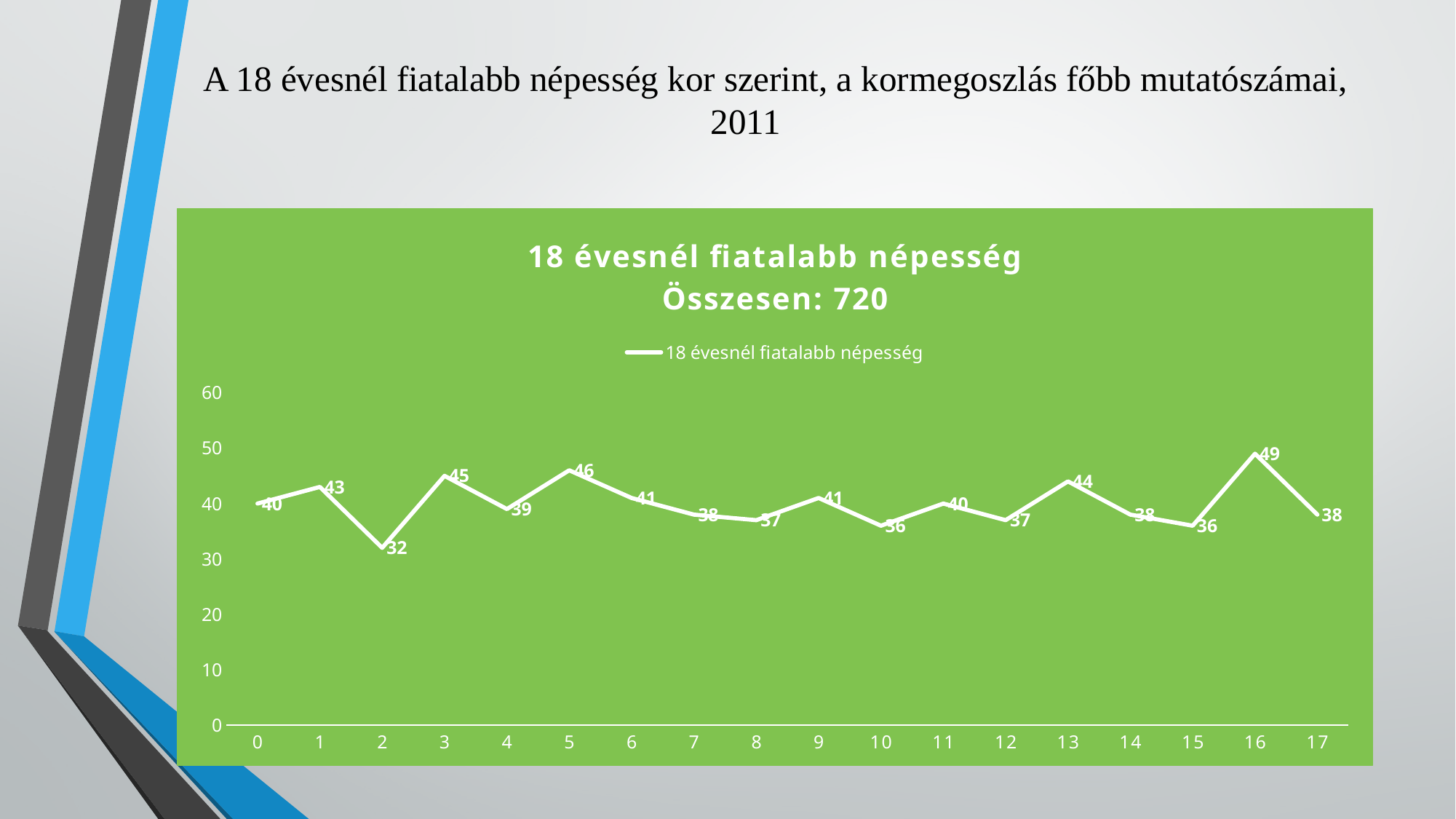
How many ages (data points) are plotted on the x axis? 18 Which age has the lowest value? 2 How many series does the legend list? 1 Which is larger, the value for age 3 or the value for age 4? age 3 What is the value for age 2? 32 What kind of chart is shown on the slide? line chart What is the value for age 5? 46 Do the values rise or fall from age 13 to age 15? fall What total is stated in the chart title? 720 What is the value for age 16? 49 Which age has the highest value? 16 What is the difference between the values for age 16 and age 2? 17